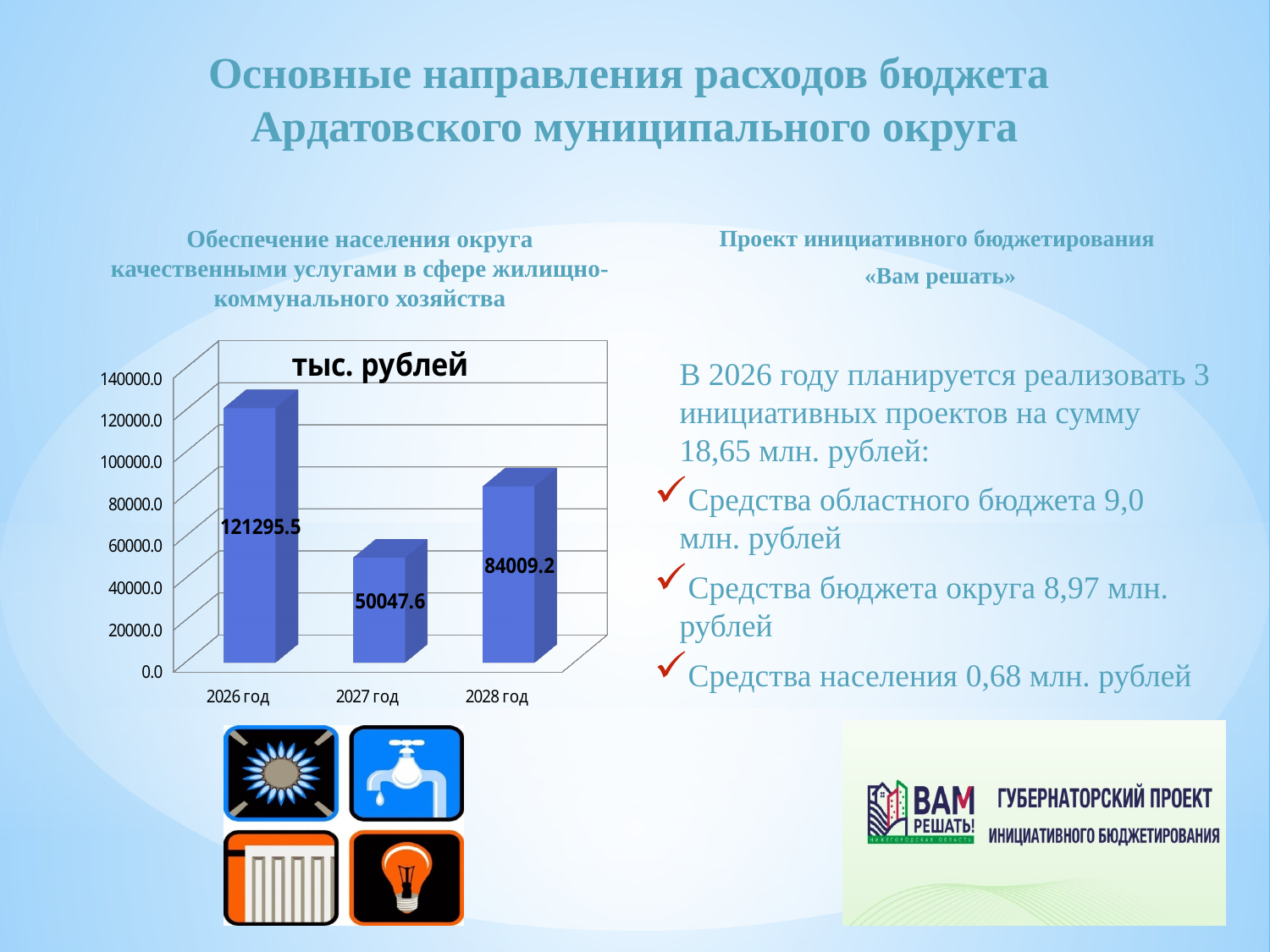
What is the value for 2028 год on the chart? 84009.2 What kind of chart is shown on the slide? bar chart How many years are shown on the chart? 3 What is the difference between the values for 2026 год and 2027 год? 71247.9 What is the value for 2027 год on the chart? 50047.6 What is the difference between the values for 2028 год and 2027 год? 33961.6 Which year has the highest value on the chart? 2026 год Is the value for 2026 год greater or less than 100000.0? greater Which is larger, the value for 2028 год or the value for 2027 год? 2028 год What is the value for 2026 год on the chart? 121295.5 Which year has the lowest value on the chart? 2027 год What is the title of the chart? тыс. рублей